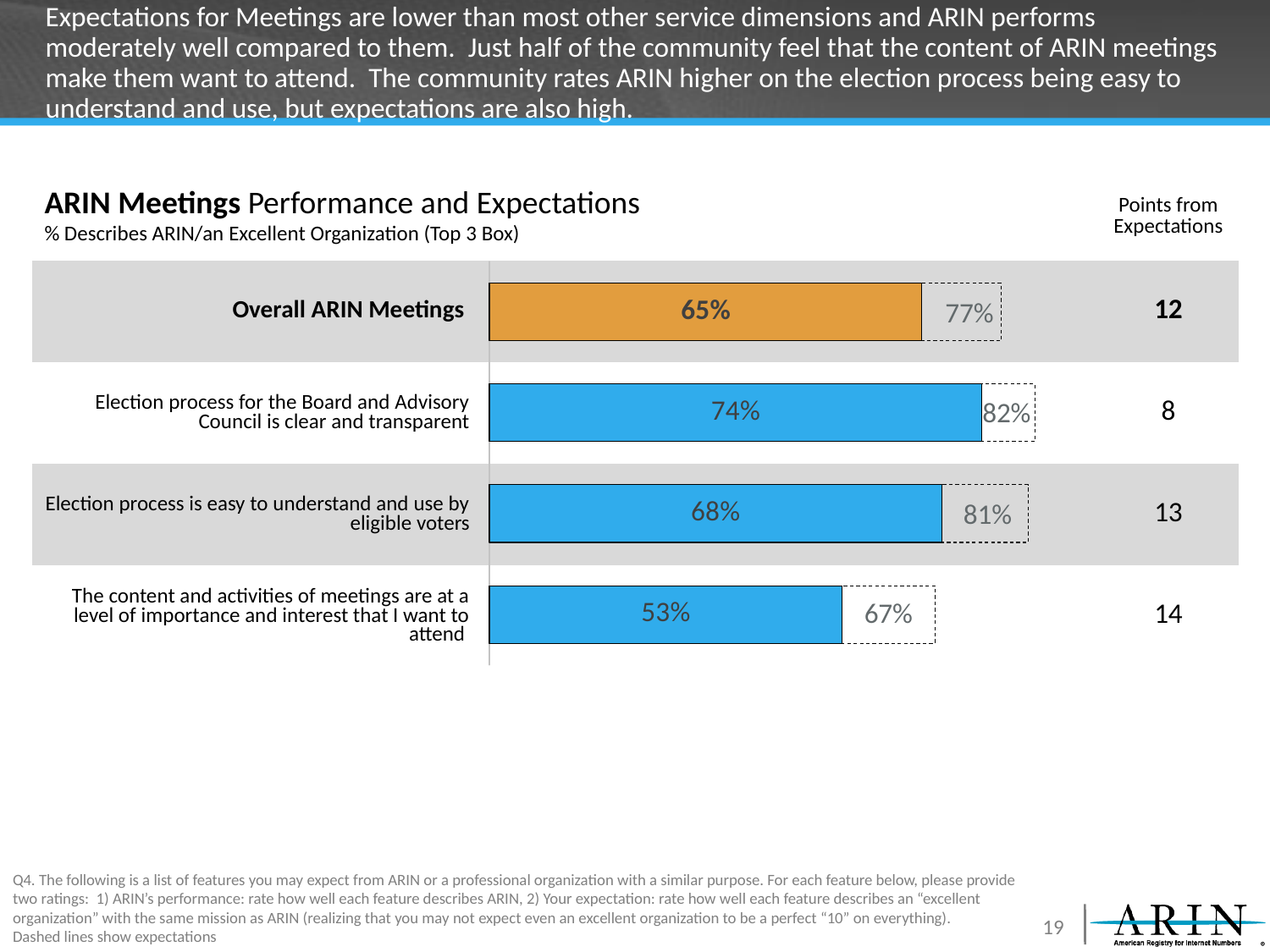
Which is larger: the performance value for "Election process is easy to understand and use by eligible voters" or for "Overall ARIN Meetings"? Election process is easy to understand and use by eligible voters What is the ARIN performance value for "Overall ARIN Meetings"? 65% Which category has the highest ARIN performance value? Election process for the Board and Advisory Council is clear and transparent What kind of chart is shown on the slide? Bar chart According to the footnote, what do the dashed lines in the chart show? Expectations What is the performance value for "The content and activities of meetings are at a level of importance and interest that I want to attend"? 53% What is the difference between the expectation and performance values for "Election process for the Board and Advisory Council is clear and transparent"? 8 Which category has the lowest expectation value? The content and activities of meetings are at a level of importance and interest that I want to attend How many categories are shown in the chart? 4 What is the expectation value (dashed bar) for "Election process is easy to understand and use by eligible voters"? 81% What is the difference between the expectation and performance values for "Overall ARIN Meetings"? 12 How many "Points from Expectations" are listed for "The content and activities of meetings are at a level of importance and interest that I want to attend"? 14